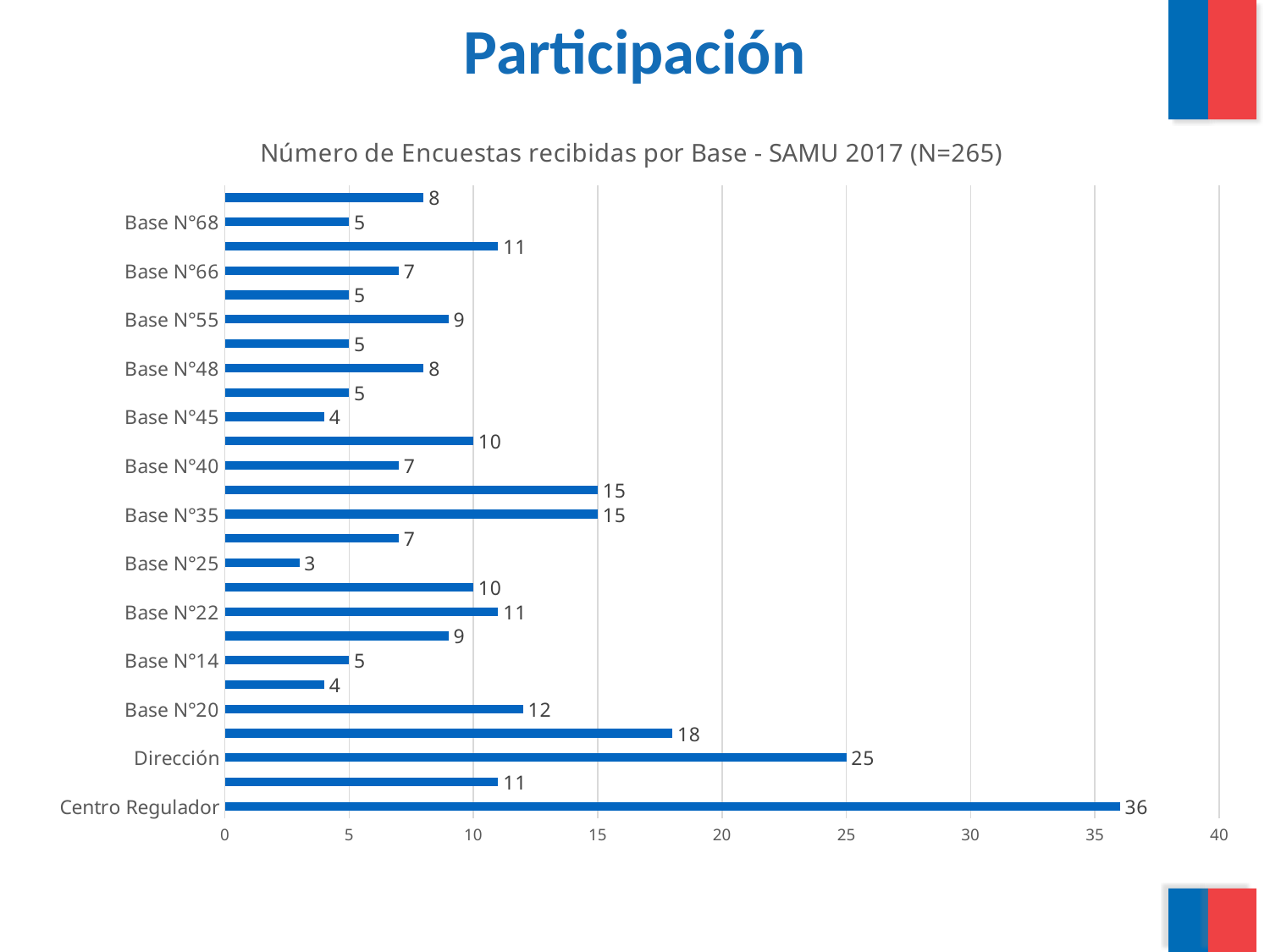
What is the difference between the values for Centro Regulador and Dirección? 11 What is the value for Centro Regulador? 36 What kind of chart is shown on the slide? bar chart What is the value for Base N°35? 15 What is the value for Dirección? 25 Is the value for Dirección greater or less than 20? greater What is the value for Base N°25? 3 Which is larger, the value for Base N°35 or the value for Base N°22? Base N°35 Which category has the highest value? Centro Regulador What is the value for Base N°20? 12 What is the title of the chart? Número de Encuestas recibidas por Base - SAMU 2017 (N=265) Which labeled category has the lowest value? Base N°25